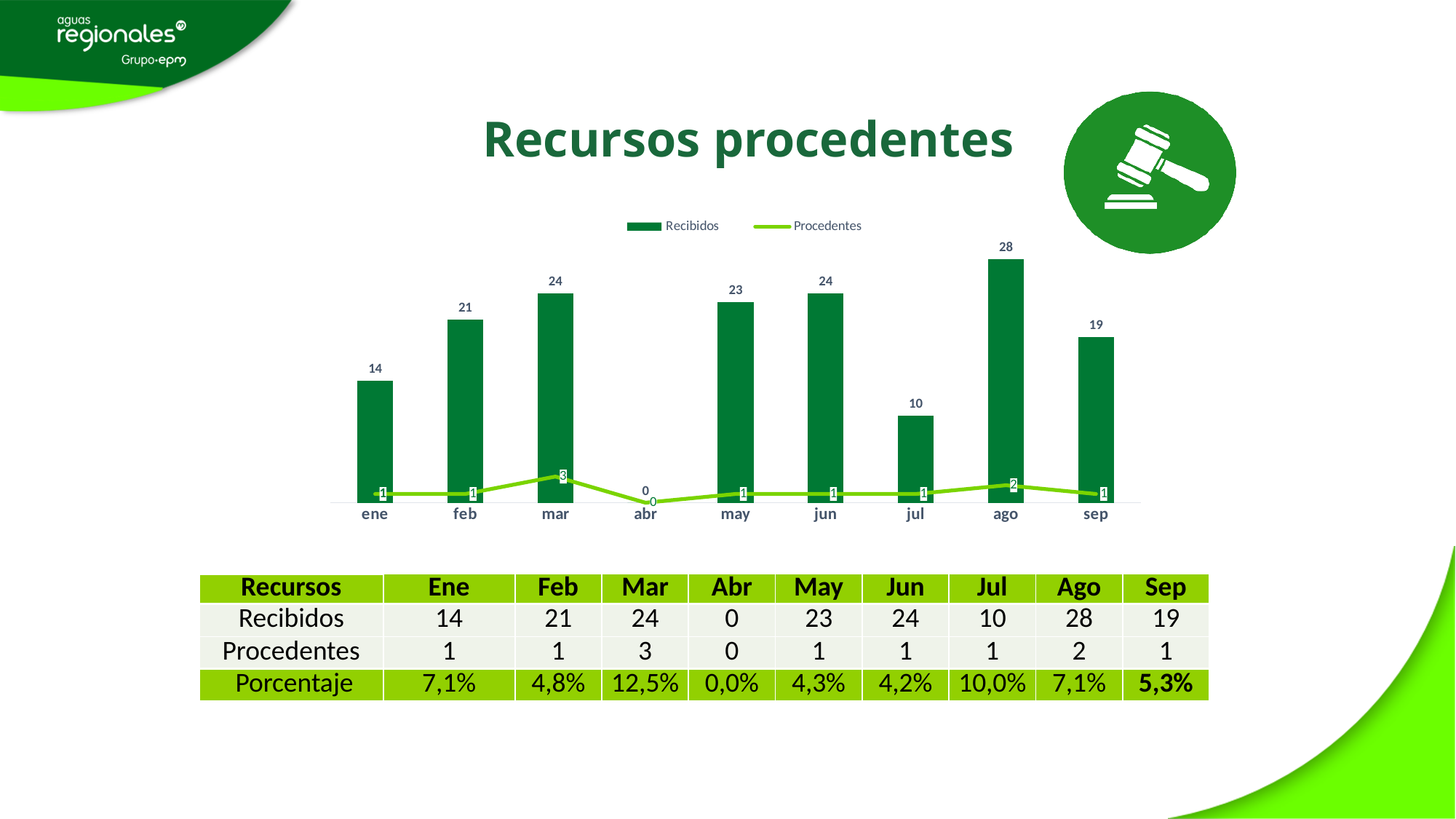
What is the title of the chart? Recursos procedentes How many months are shown on the x axis of the chart? 9 How many series does the chart legend list? 2 What is the difference between the Recibidos values for ago and jul? 18 Do the Recibidos values rise or fall from jul to ago? rise Which series is shown as a line in the chart? Procedentes Which is larger, the Recibidos value for feb or for sep? feb What kind of chart is used for the Recibidos series? bar chart Which month has the highest Recibidos value? ago What is the Recibidos value for ago? 28 Which month has the lowest Recibidos value? abr What is the Procedentes value for mar? 3